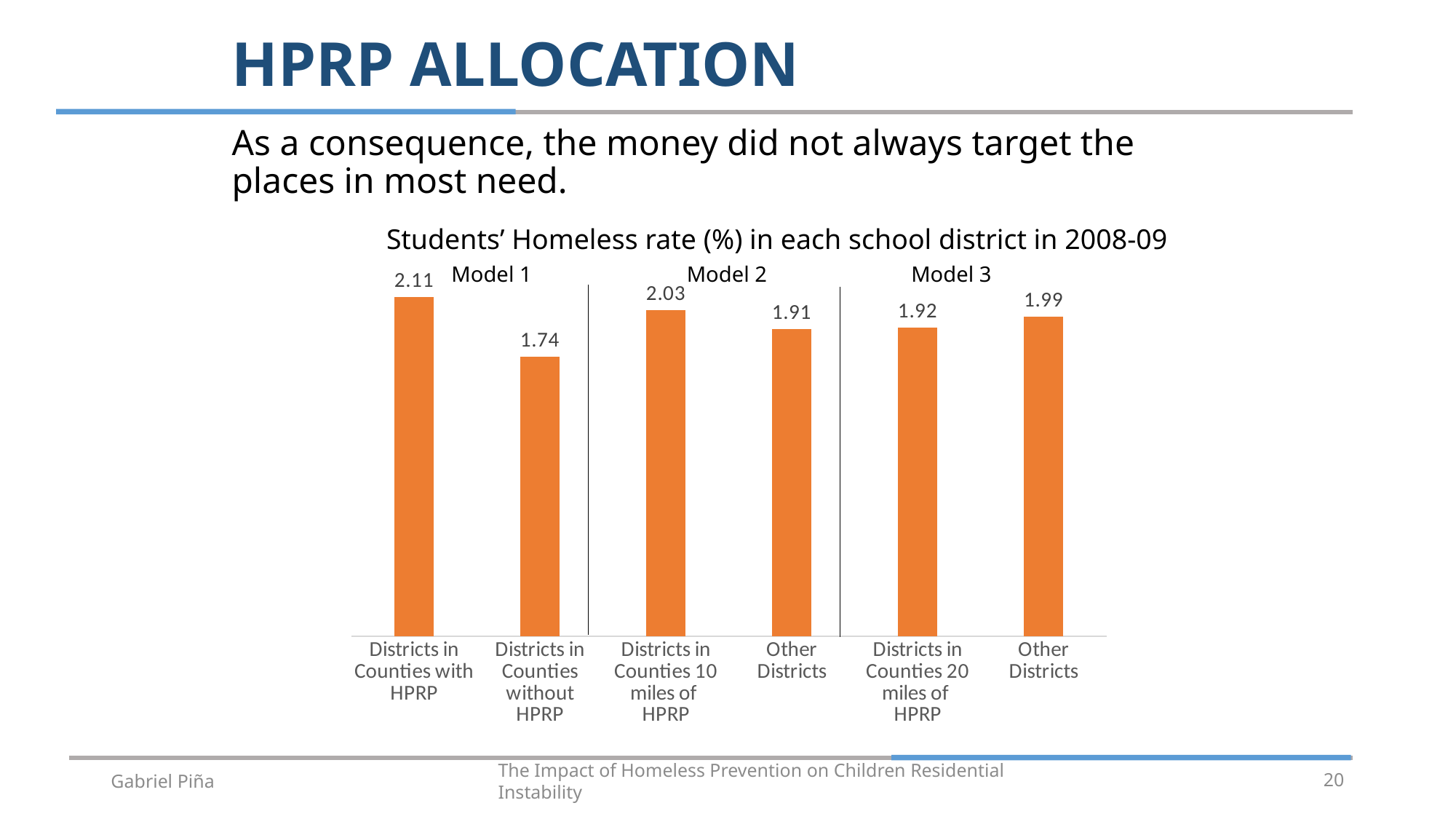
What type of chart is shown on the slide? Bar chart Which category has the highest students' homeless rate? Districts in Counties with HPRP What is the difference between the rates for Districts in Counties with HPRP and Districts in Counties without HPRP? 0.37 Which category has the lowest students' homeless rate? Districts in Counties without HPRP How many bars are plotted in the chart? 6 What is the students' homeless rate for Districts in Counties without HPRP? 1.74 What is the value for Districts in Counties 10 miles of HPRP under Model 2? 2.03 Under Model 3, which is larger: Districts in Counties 20 miles of HPRP or Other Districts? Other Districts What is the title of the chart? Students' Homeless rate (%) in each school district in 2008-09 What is the difference between Districts in Counties 10 miles of HPRP and Other Districts under Model 2? 0.12 What is the value for Other Districts under Model 3? 1.99 What is the students' homeless rate for Districts in Counties with HPRP? 2.11